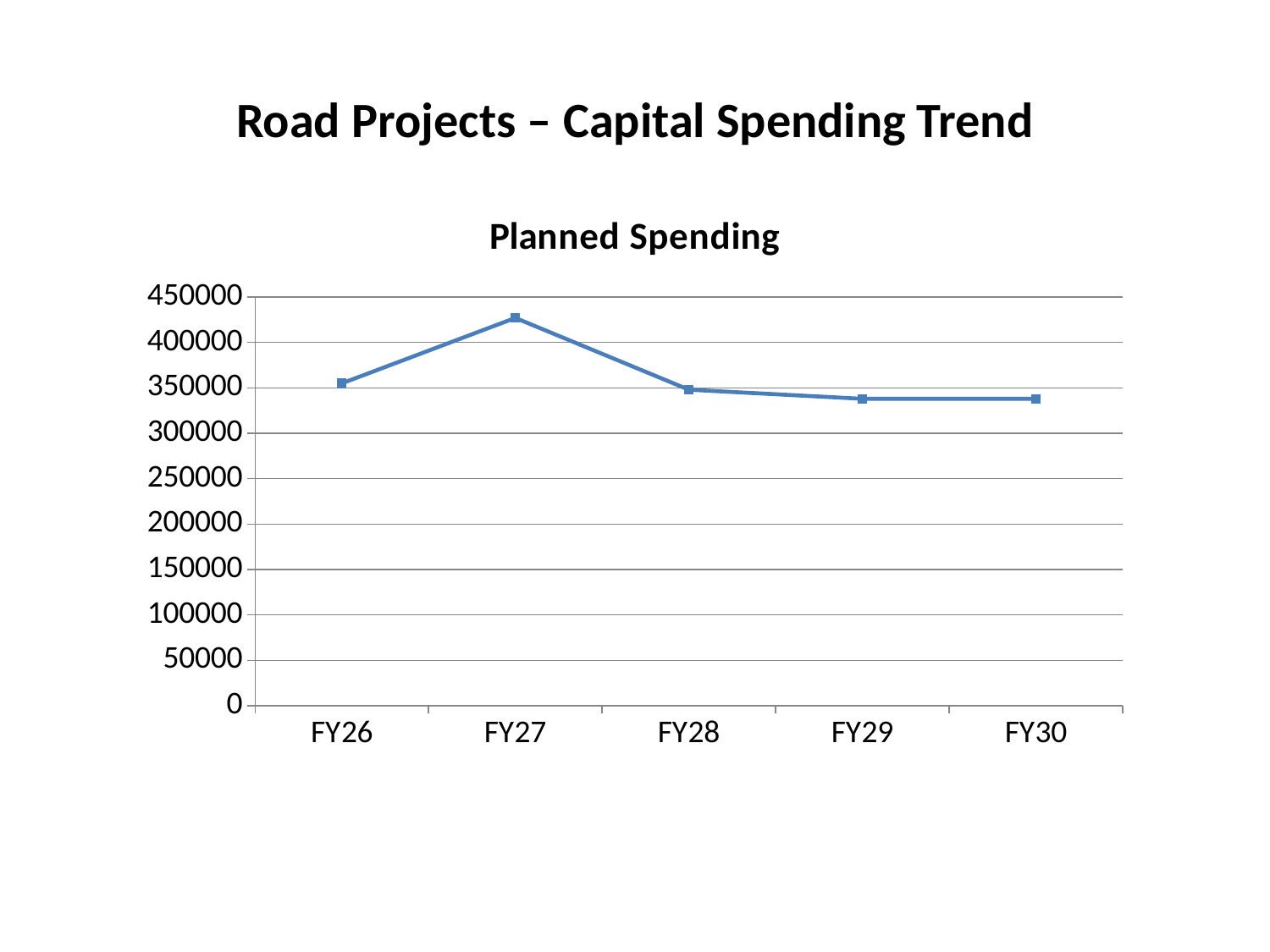
Is the value for FY30 greater or less than 300000? greater What kind of chart is shown on the slide? line chart Which is larger, the value for FY27 or the value for FY28? FY27 Which is larger, the value for FY26 or the value for FY29? FY26 Which fiscal year has the highest planned spending? FY27 Is the value for FY29 greater or less than 350000? less Is the value for FY27 greater or less than 450000? less Do the values rise or fall from FY27 to FY29? fall How many fiscal years are plotted on the x axis? 5 What is the title of the chart? Planned Spending